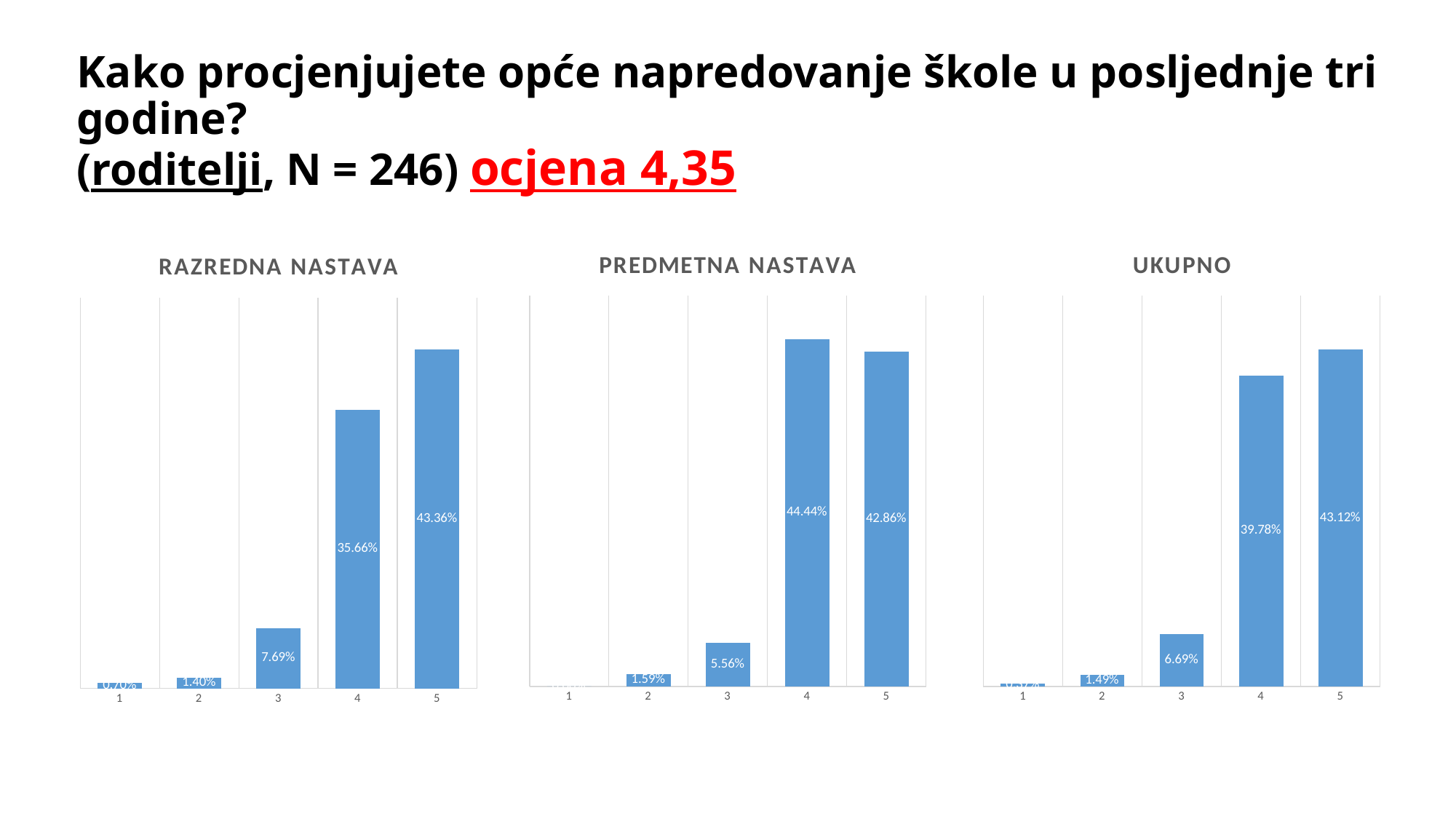
In the UKUPNO chart, what is the value for category 4? 39.78% In the PREDMETNA NASTAVA chart, what is the value for category 3? 5.56% How many categories does the UKUPNO chart show? 5 What kind of chart is the PREDMETNA NASTAVA chart? bar chart In the UKUPNO chart, what is the difference between the values for category 5 and category 4? 3.34% In the RAZREDNA NASTAVA chart, what is the value for category 5? 43.36% How many charts are shown on the slide? 3 In the RAZREDNA NASTAVA chart, which category has the highest value? 5 In the PREDMETNA NASTAVA chart, which is larger, the value for category 4 or category 5? category 4 In the PREDMETNA NASTAVA chart, which category has the highest value? 4 In the UKUPNO chart, which category has the lowest value? 1 In the RAZREDNA NASTAVA chart, what is the difference between the values for category 5 and category 4? 7.70%